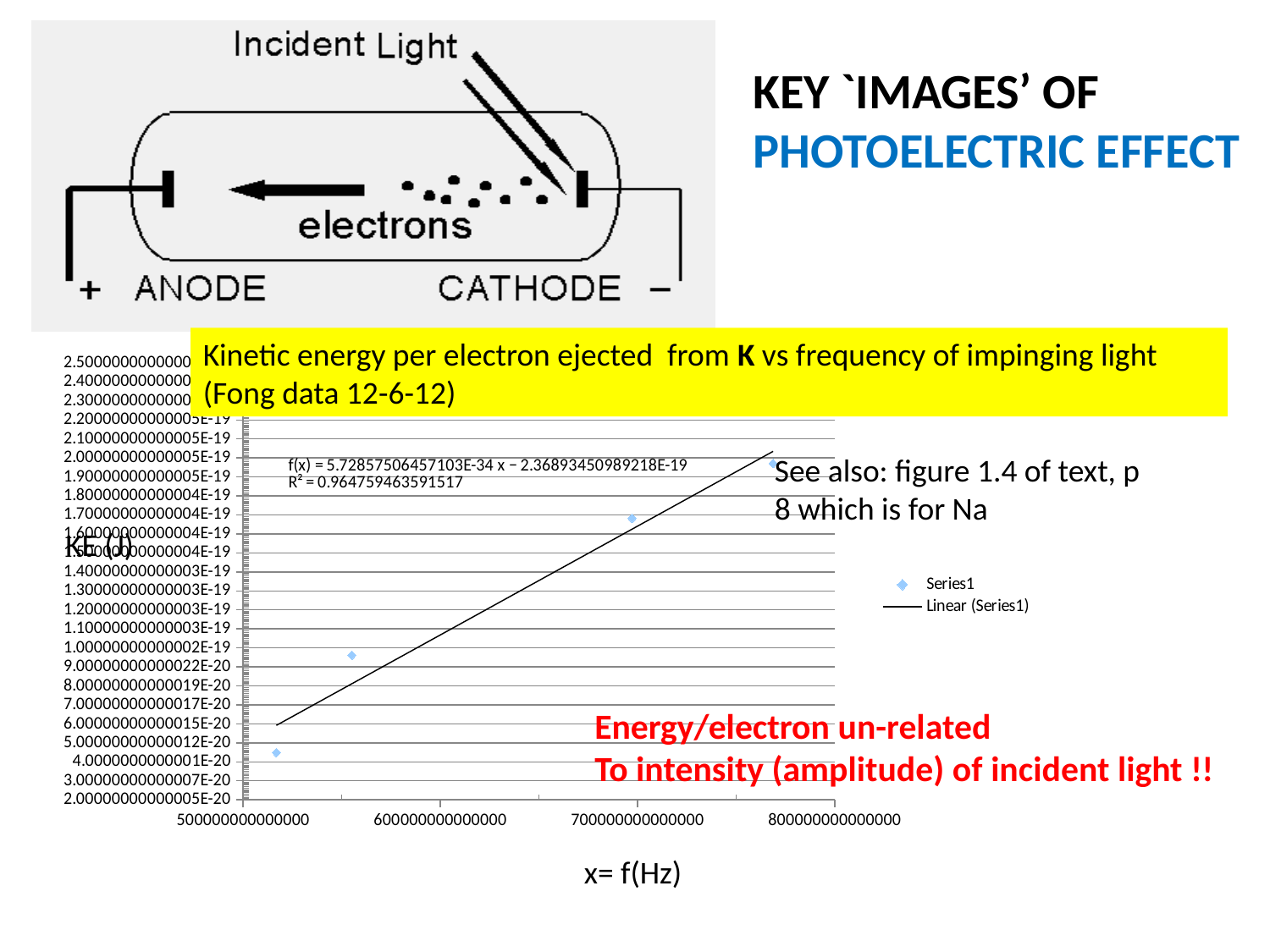
Do the plotted kinetic energy values rise or fall as frequency increases along the x axis? rise Which plotted point has the highest kinetic energy: the one at the lowest frequency or the one at the highest frequency? the one at the highest frequency What is the intercept of the fitted line shown in the trendline equation on the chart? -2.36893450989218E-19 How many data points are plotted in the chart? 4 What is the R² value shown for the linear fit on the chart? 0.964759463591517 What kind of chart is shown on the slide? scatter chart Is the kinetic energy of the leftmost data point (near 500000000000000 Hz) greater or less than 1.00000000000002E-19? less What is the label on the x axis of the chart? x= f(Hz) What is the slope of the fitted line shown in the trendline equation on the chart? 5.72857506457103E-34 Is the kinetic energy of the rightmost data point greater or less than 1.50000000000004E-19? greater How many entries does the chart legend list? 2